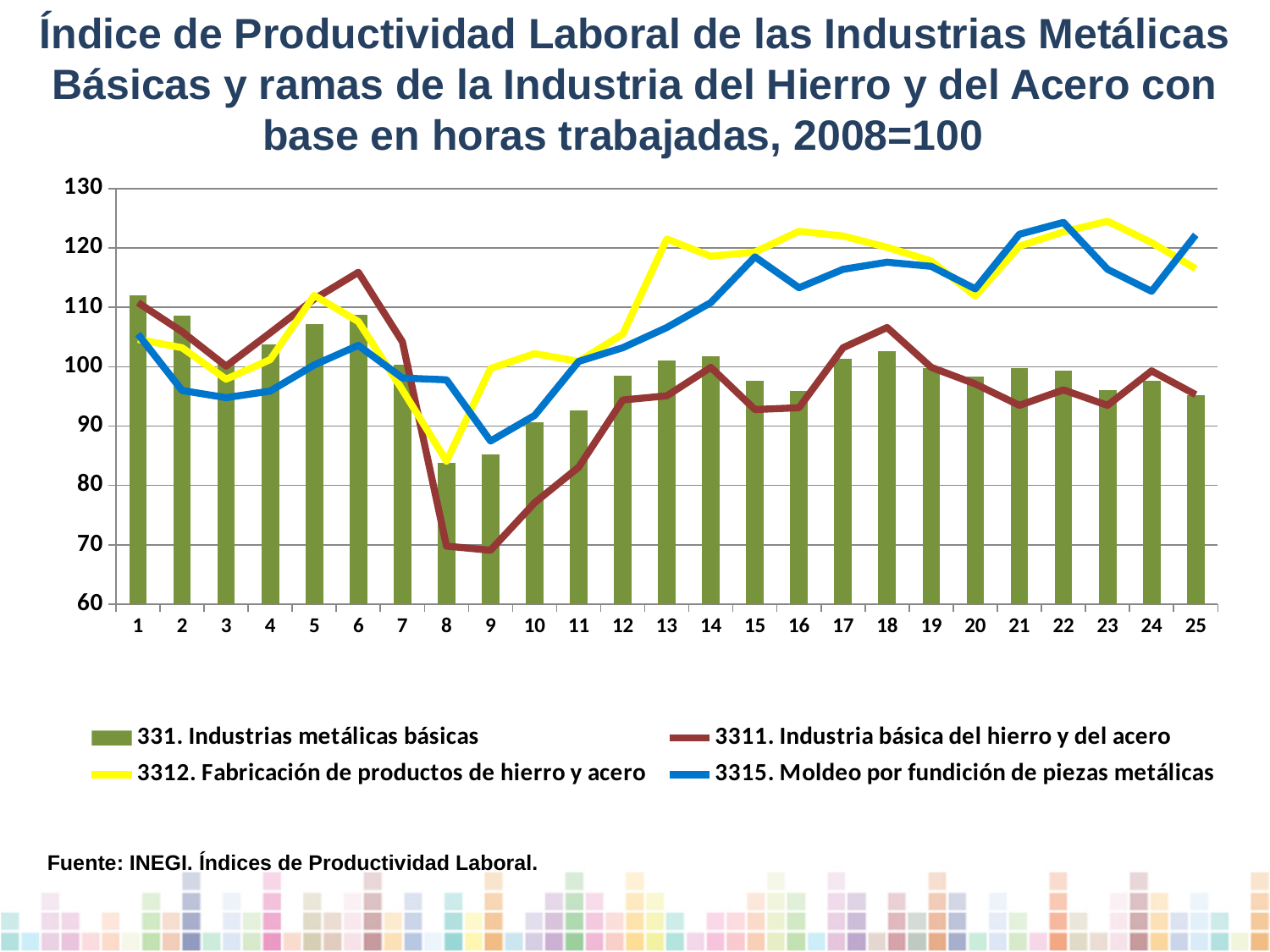
In which period does the line for 3315. Moldeo por fundición de piezas metálicas reach its lowest value? 9 In period 13, which is larger: 3312. Fabricación de productos de hierro y acero or 3315. Moldeo por fundición de piezas metálicas? 3312. Fabricación de productos de hierro y acero Does the line for 3311. Industria básica del hierro y del acero rise or fall from period 9 to period 13? rise In which period is the bar for 331. Industrias metálicas básicas the highest? 1 Is the bar for 331. Industrias metálicas básicas in period 8 greater or less than 90? less How many periods are shown along the x axis? 25 In which period does the line for 3311. Industria básica del hierro y del acero reach its highest value? 6 Is the value for 3311. Industria básica del hierro y del acero in period 8 greater or less than 80? less In which period does the line for 3312. Fabricación de productos de hierro y acero reach its lowest value? 8 How many series does the legend list? 4 What kind of chart is shown on the slide? A combined bar and line chart Is the value for 3312. Fabricación de productos de hierro y acero in period 13 greater or less than 120? greater